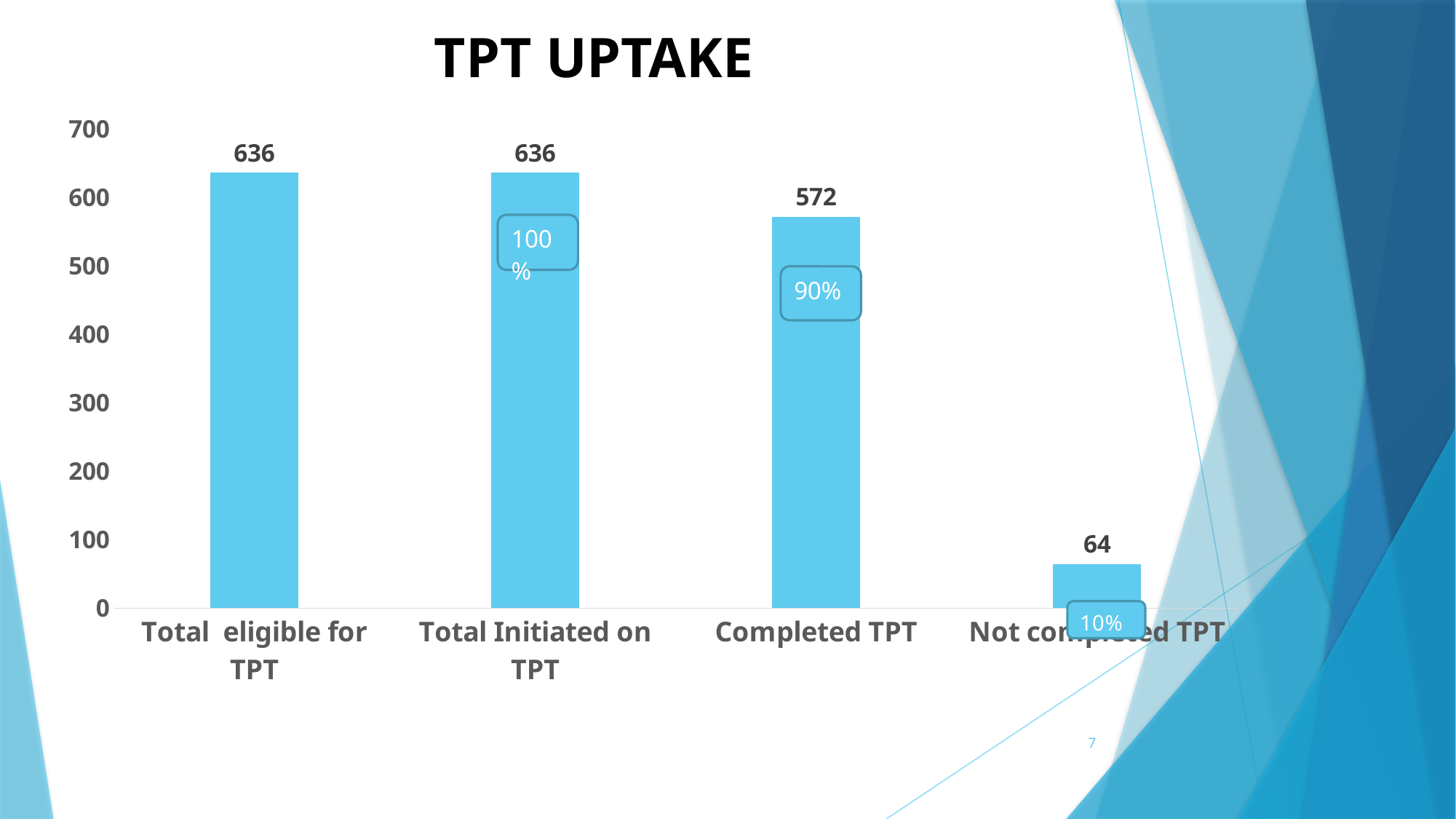
What is the value for Not completed TPT? 64 What is the title of the chart? TPT UPTAKE Which category has the lowest value? Not completed TPT What is the value for Total Initiated on TPT? 636 Which is larger, Completed TPT or Not completed TPT? Completed TPT What kind of chart is shown on the slide? bar chart Is the value for Completed TPT greater or less than 500? greater What is the value for Total eligible for TPT? 636 What is the difference between Total Initiated on TPT and Completed TPT? 64 What is the difference between Completed TPT and Not completed TPT? 508 What is the value for Completed TPT? 572 How many categories are shown on the chart? 4